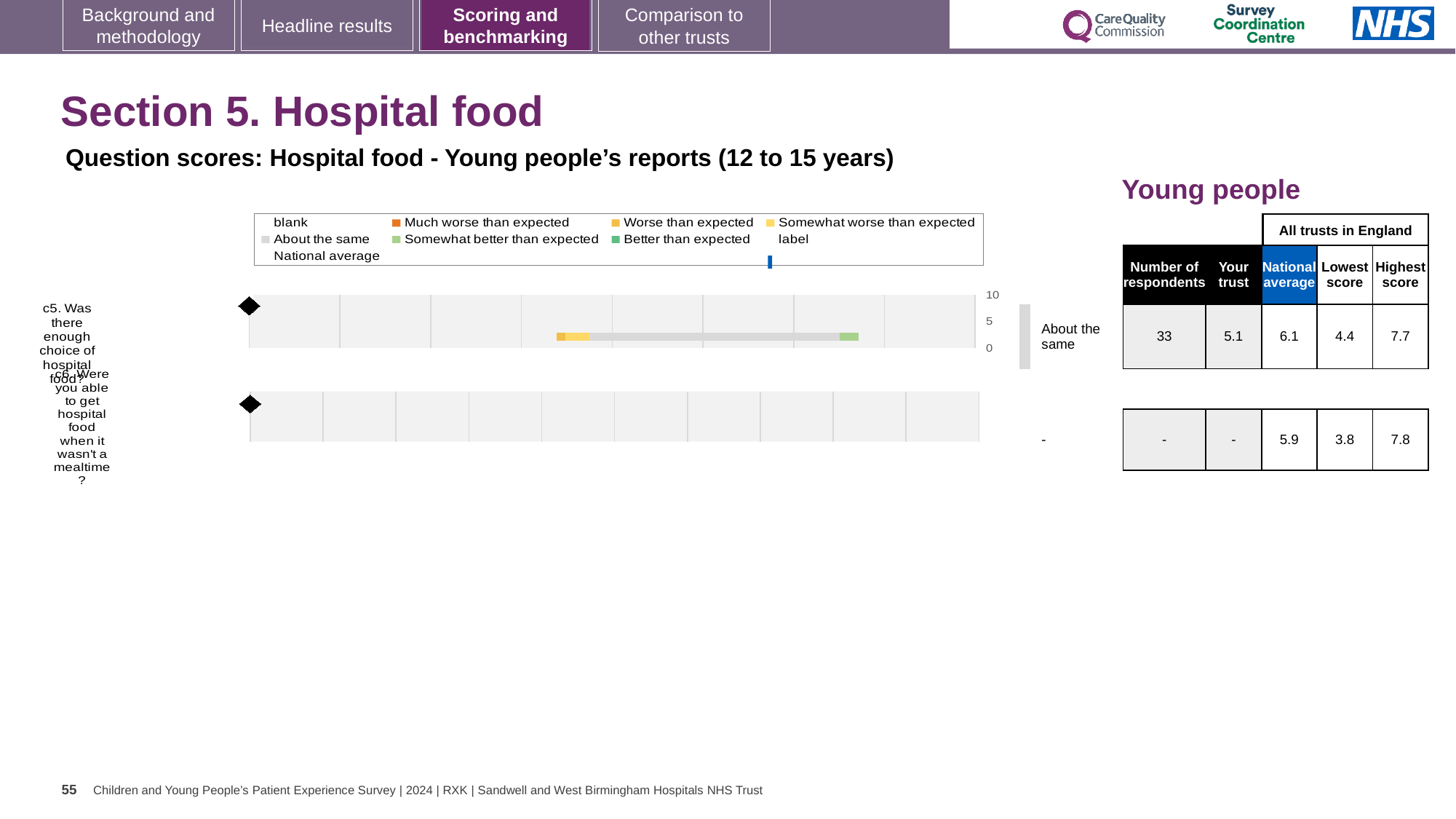
In the table, how many respondents answered question c5? 33 In the table, what is the national average score for question c5? 6.1 In the table, what is the lowest score across all trusts in England for question c5? 4.4 In the table, what is the 'Your trust' score for question c5? 5.1 What type of chart is used to show the question scores for hospital food? bar chart How many questions (categories) are plotted in the hospital food chart? 2 Which benchmark category is shown for question c5 (enough choice of hospital food)? About the same Which question has the higher national average score, c5 or c6? c5 For question c5, which is larger: the trust's score or the national average? national average In the table, what is the national average score for question c6? 5.9 What is the difference between the highest score (7.7) and the lowest score (4.4) for question c5? 3.3 In the table, what is the highest score across all trusts in England for question c6? 7.8